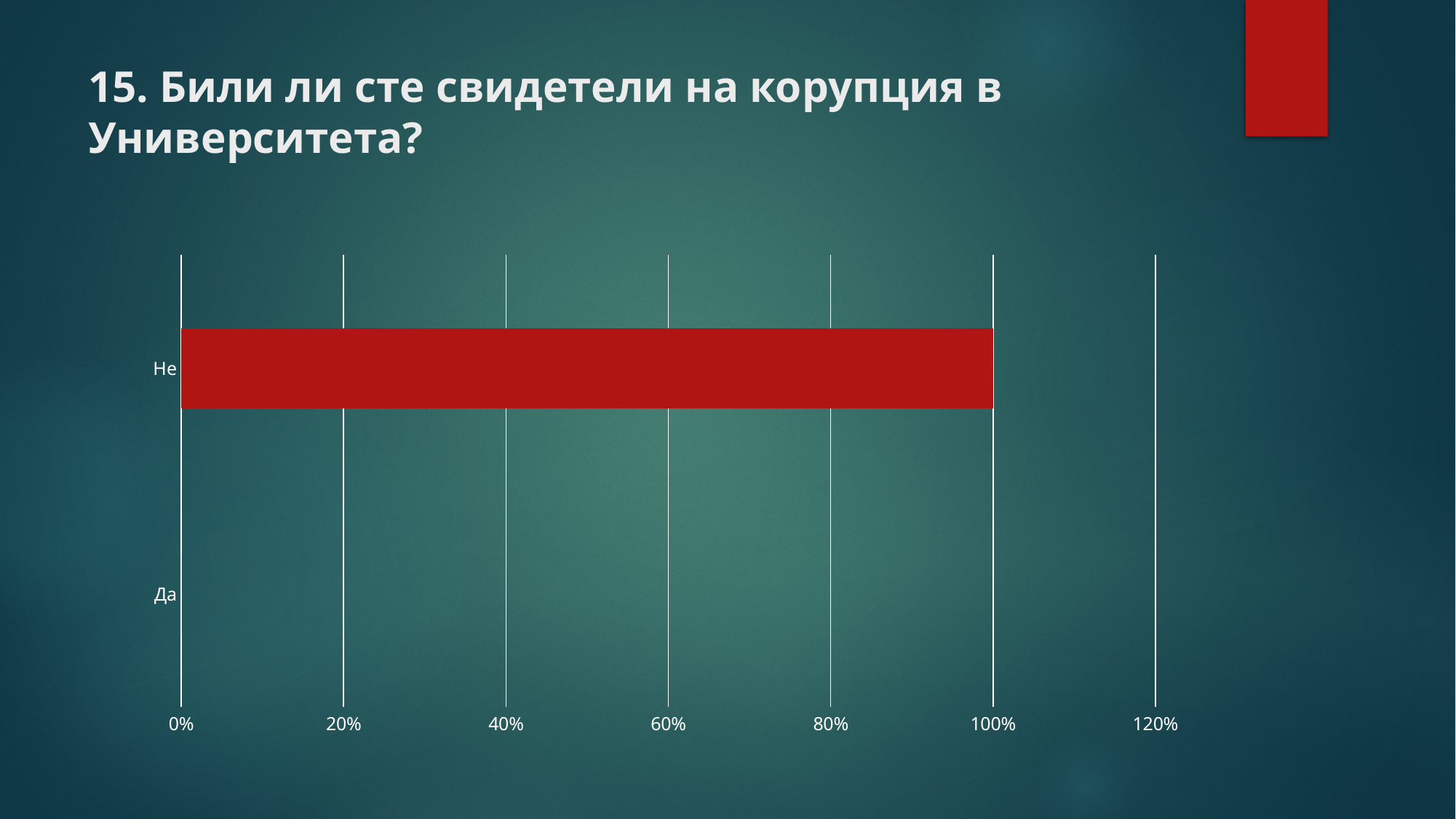
Which category has the highest value? Не Which category has the lowest value? Да How many categories are shown on the chart? 2 Is the value for "Не" greater or less than 80%? greater What is the difference between the values for "Не" and "Да"? 100% What is the value for "Не"? 100% Is the value for "Да" greater or less than 20%? less What is the title of the slide? 15. Били ли сте свидетели на корупция в Университета? What is the value for "Да"? 0% Which is larger, the value for "Не" or the value for "Да"? Не What colour is the bar on the chart? red What kind of chart is shown on the slide? bar chart